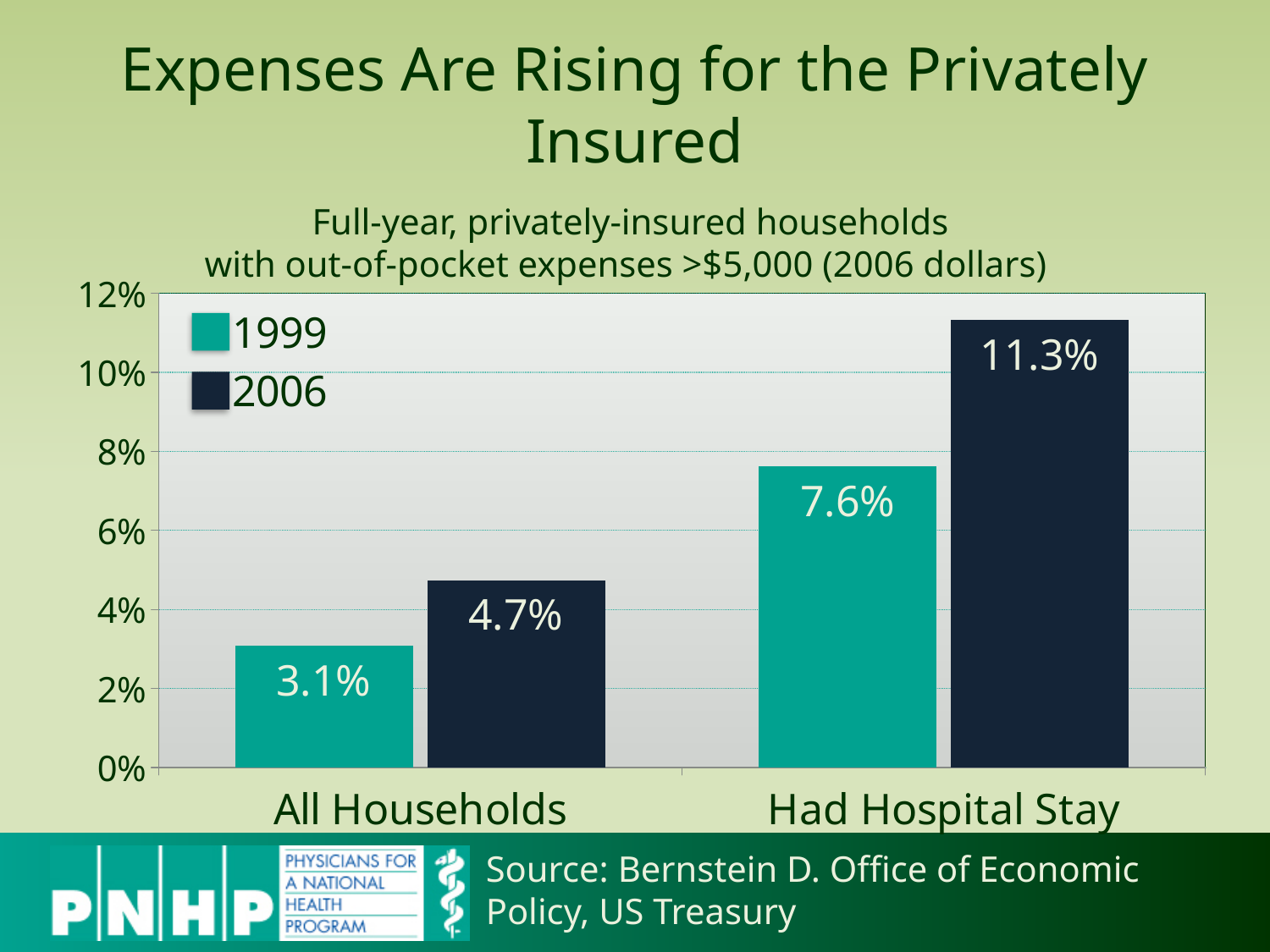
Which category has the lowest value in the 1999 series? All Households What is the difference between the 2006 and 1999 values for All Households? 1.6% Which is larger: the 1999 value for Had Hospital Stay or the 2006 value for All Households? 1999 value for Had Hospital Stay What is the value for Had Hospital Stay in 2006? 11.3% Which category has the highest value in the 2006 series? Had Hospital Stay What kind of chart is shown on the slide? Bar chart How many series does the legend list? 2 What is the difference between the 2006 and 1999 values for Had Hospital Stay? 3.7% What is the value for All Households in 2006? 4.7% What is the value for Had Hospital Stay in 1999? 7.6% What is the value for All Households in 1999? 3.1% How many categories are shown on the x axis? 2